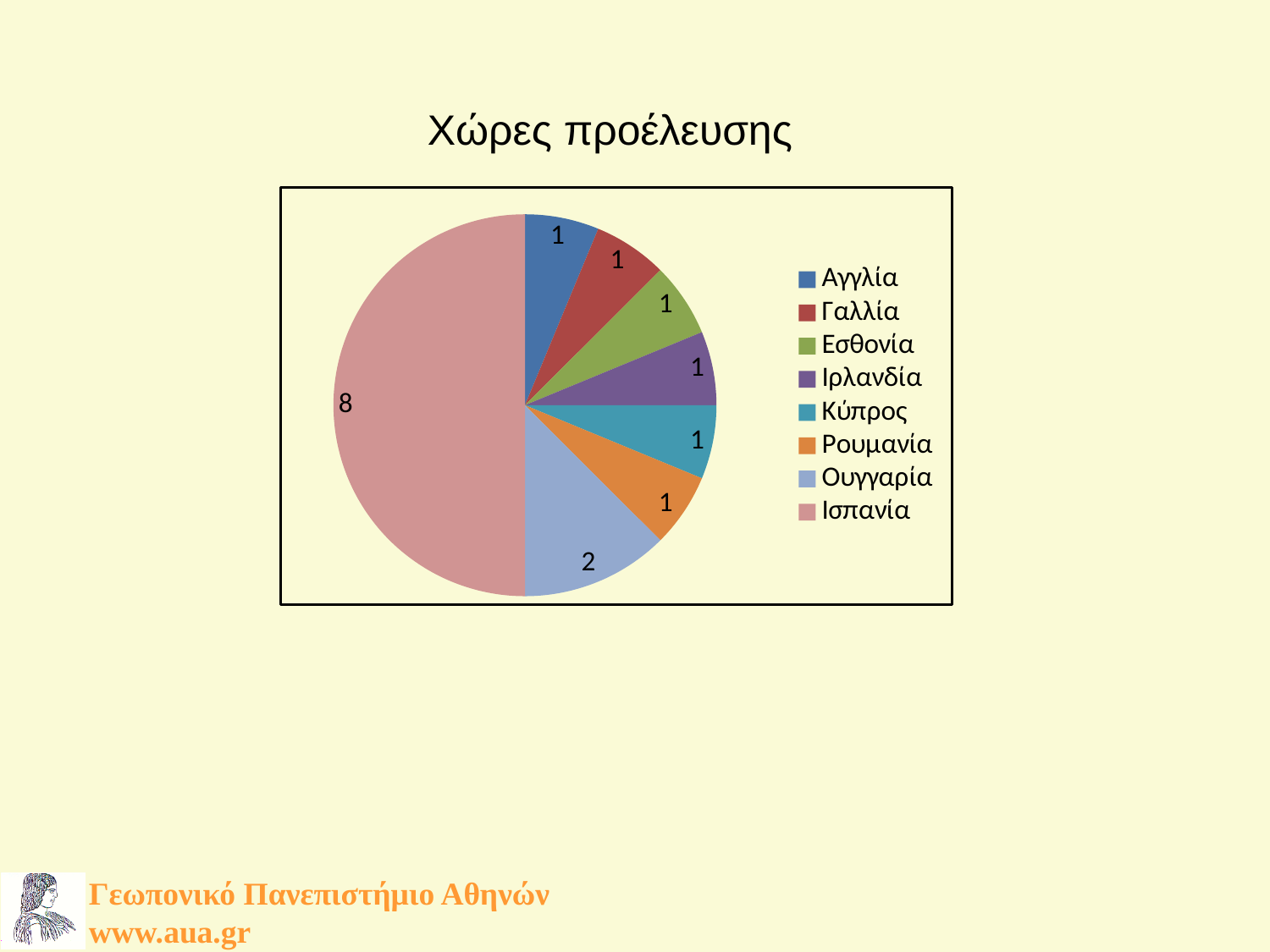
What is the title of the chart? Χώρες προέλευσης What is the value for Ισπανία? 8 What share of the pie does Ισπανία represent? 50% What is the value for Κύπρος? 1 What is the difference between the values for Ισπανία and Ουγγαρία? 6 What is the value for Ουγγαρία? 2 Which legend entry is shown in green? Εσθονία What kind of chart is shown on the slide? pie chart Which is larger, the value for Ουγγαρία or the value for Ρουμανία? Ουγγαρία Which country has the largest slice of the pie? Ισπανία How many categories does the legend list? 8 What is the total of all the slices in the pie? 16